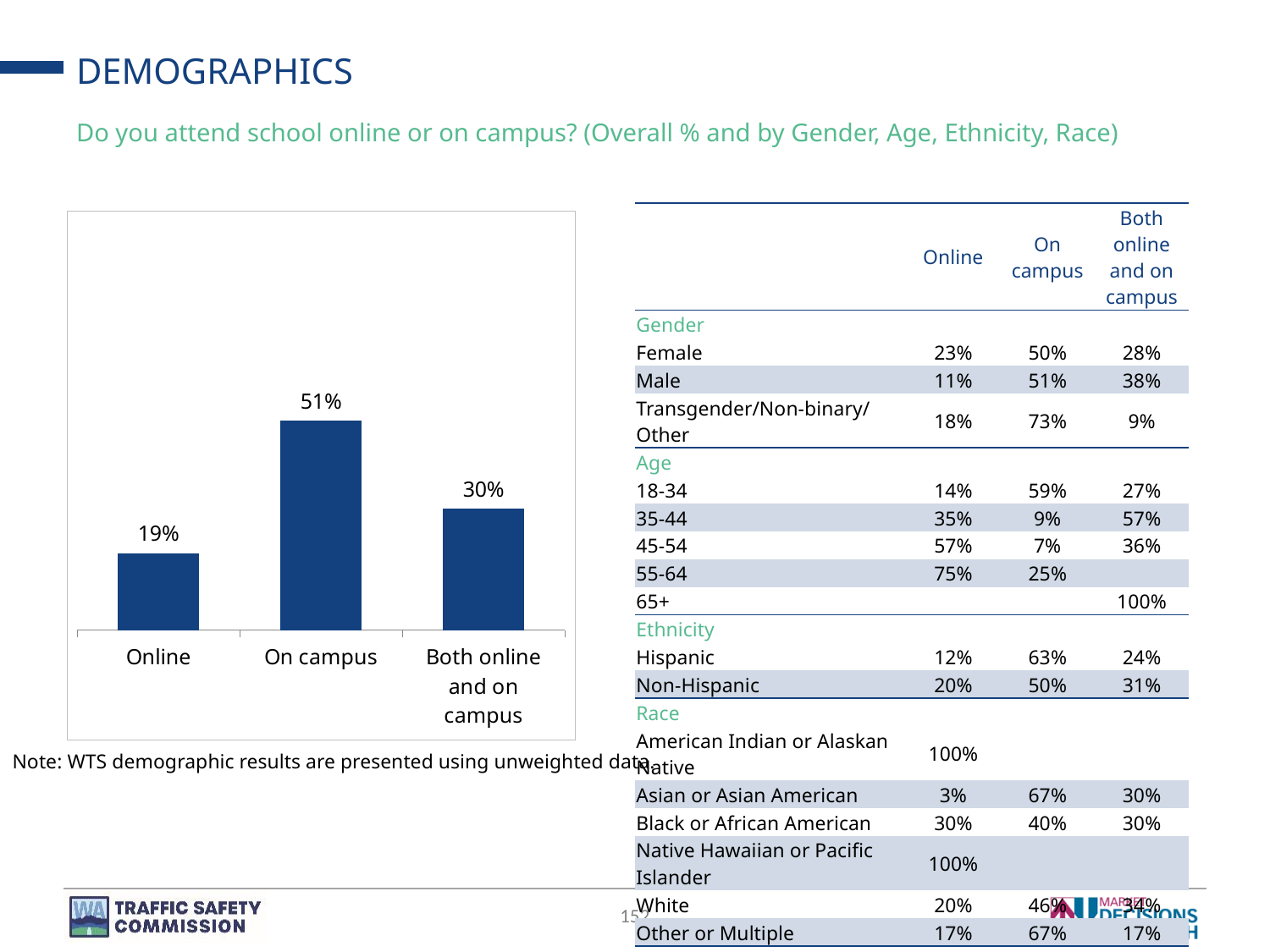
Which category has the highest percentage in the bar chart? On campus What question does the chart on the slide answer? Do you attend school online or on campus? What type of chart is shown on the left of the slide? Bar chart What percentage of respondents attend school on campus? 51% What is the difference in percentage points between Both online and on campus and Online? 11 What is the difference in percentage points between On campus and Online? 32 Which is larger, the percentage for Both online and on campus or the percentage for Online? Both online and on campus Which category has the lowest percentage in the bar chart? Online How many categories are shown in the bar chart? 3 What percentage of respondents attend school online? 19% What percentage of respondents attend school both online and on campus? 30% What is the total of the three percentages shown in the bar chart? 100%